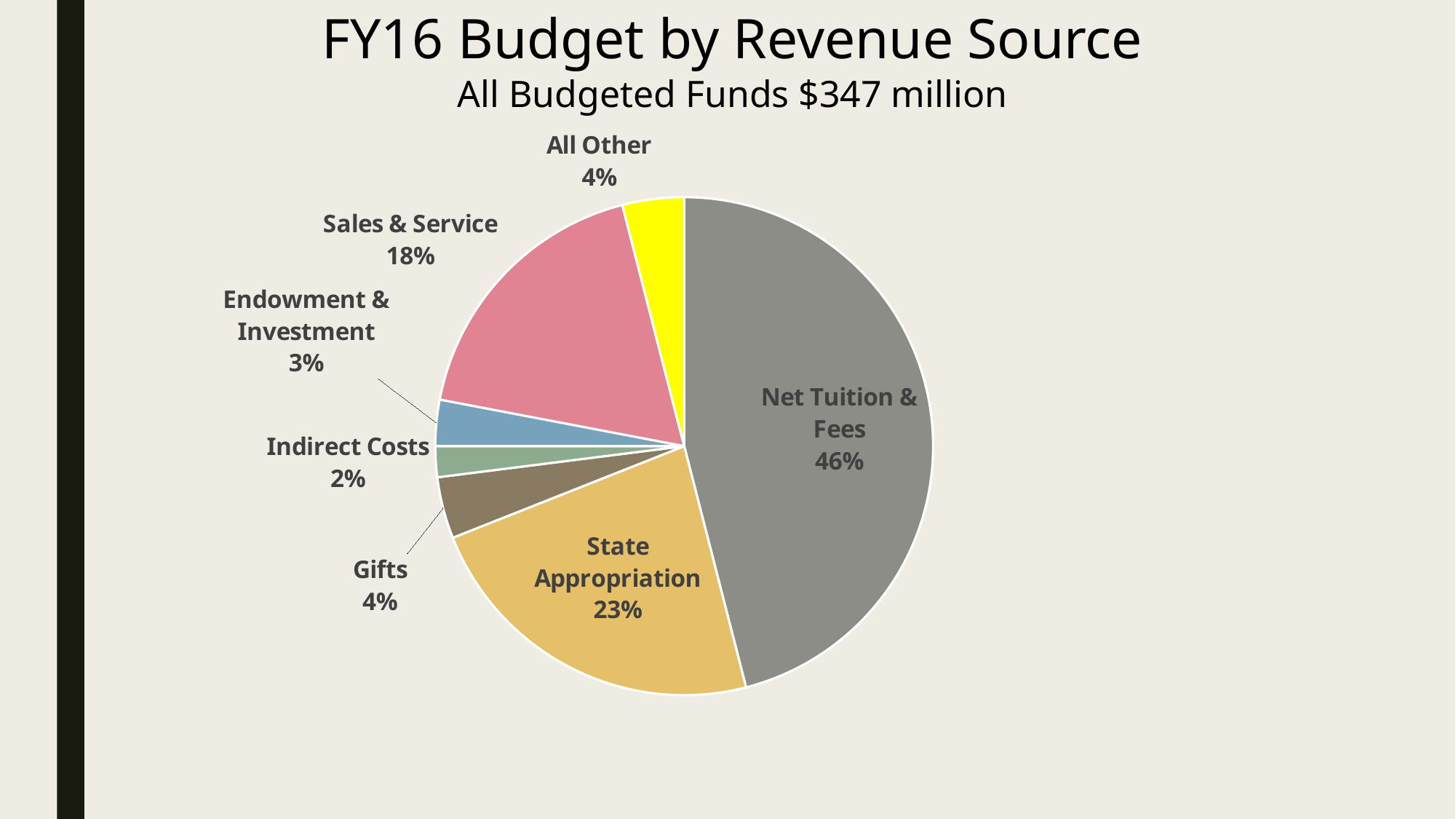
What is the total of all budgeted funds stated in the chart subtitle? $347 million What percentage does Sales & Service contribute? 18% What type of chart is shown on the slide? Pie chart Which is larger, Sales & Service or State Appropriation? State Appropriation How many revenue sources are shown in the pie chart? 7 What share of the FY16 budget comes from Net Tuition & Fees? 46% What is the percentage for Endowment & Investment? 3% What is the difference in percentage points between Net Tuition & Fees and State Appropriation? 23 Which revenue source has the largest share of the budget? Net Tuition & Fees What percentage of the budget is State Appropriation? 23% What colour is the Net Tuition & Fees slice? Gray Which revenue source has the smallest share of the budget? Indirect Costs